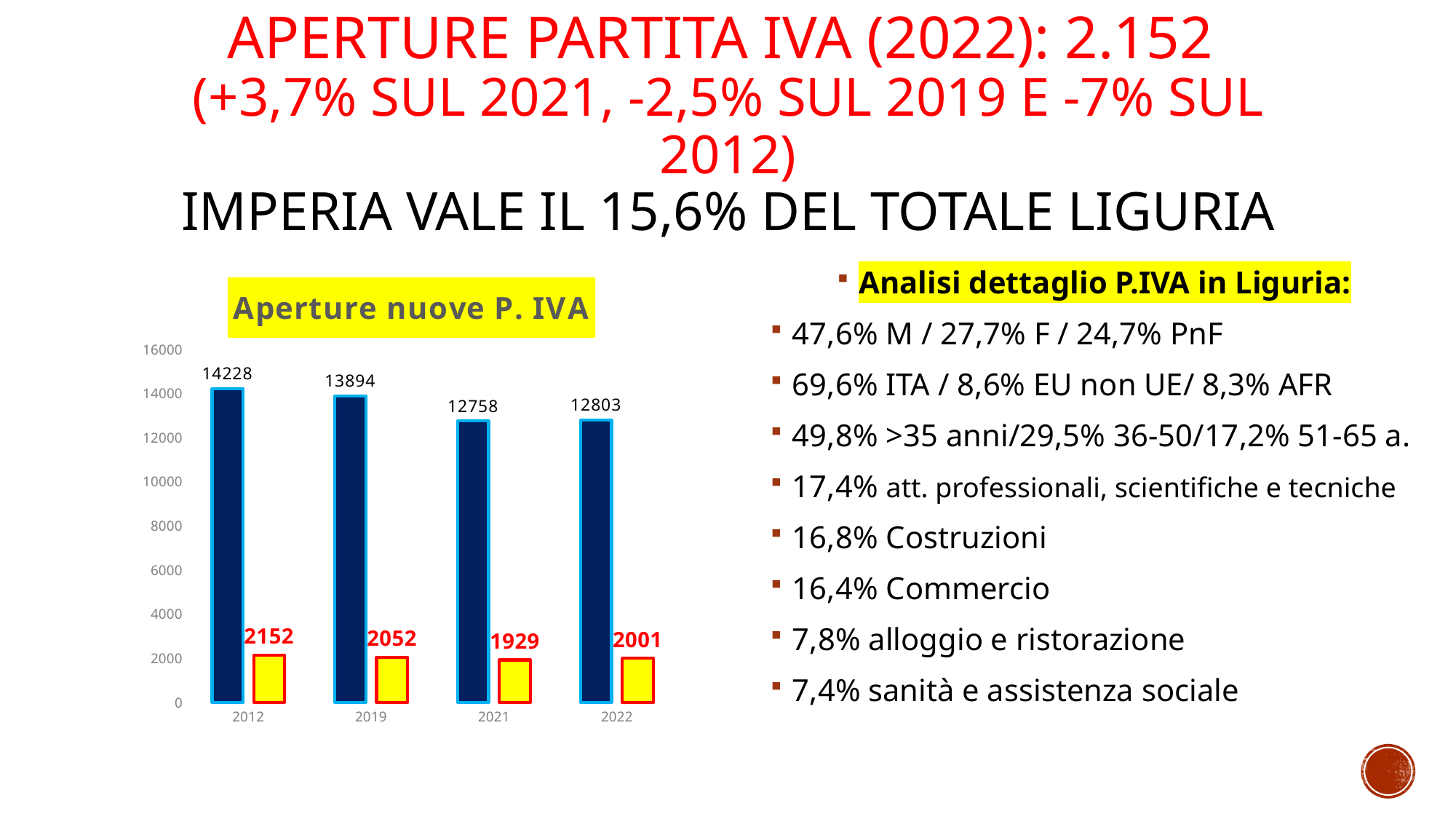
In the "Aperture nuove P. IVA" chart, is the dark blue bar for 2022 greater or less than 14000? less In the "Aperture nuove P. IVA" chart, which year has the highest dark blue bar? 2012 What type of chart is "Aperture nuove P. IVA"? bar chart In the "Aperture nuove P. IVA" chart, what is the value of the dark blue bar for 2012? 14228 In the "Aperture nuove P. IVA" chart, what is the difference between the dark blue bars for 2012 and 2019? 334 What is the title of the chart on the slide? Aperture nuove P. IVA In the "Aperture nuove P. IVA" chart, what is the value of the yellow bar for 2022? 2001 In the "Aperture nuove P. IVA" chart, is the yellow bar for 2021 larger or smaller than the yellow bar for 2019? smaller In the "Aperture nuove P. IVA" chart, which year has the lowest yellow bar? 2021 How many years are shown on the x axis of the "Aperture nuove P. IVA" chart? 4 In the "Aperture nuove P. IVA" chart, what is the value of the dark blue bar for 2021? 12758 In the "Aperture nuove P. IVA" chart, what is the difference between the yellow bars for 2012 and 2022? 151